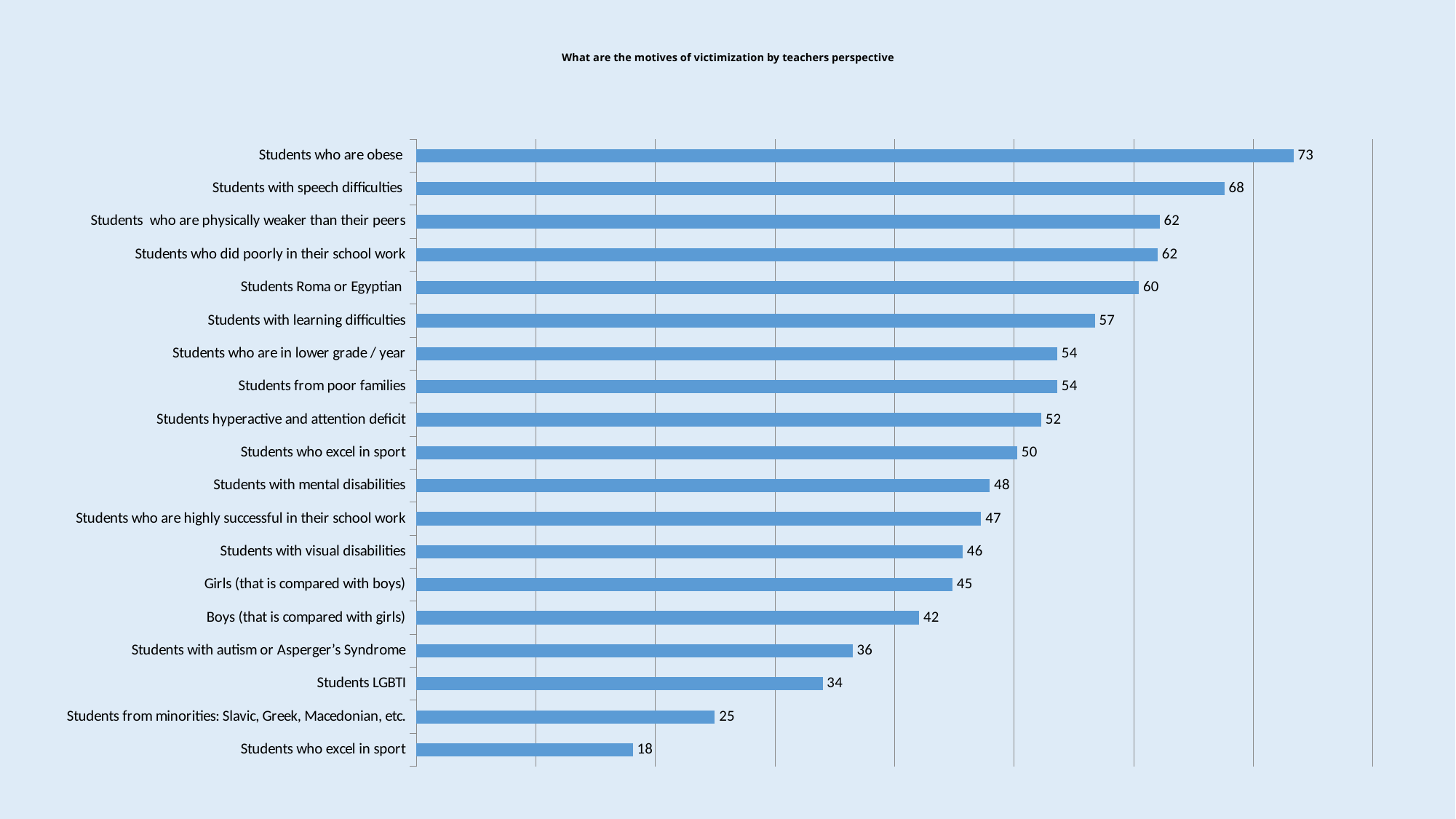
How many categories are shown on the chart? 19 What is the value for Students from minorities: Slavic, Greek, Macedonian, etc.? 25 What is the value for Students with speech difficulties? 68 What is the value for Students Roma or Egyptian? 60 What is the difference between the values for Boys (that is compared with girls) and Students with autism or Asperger's Syndrome? 6 What is the lowest value shown on the chart? 18 What is the value for Students who are obese? 73 What is the value for Students LGBTI? 34 Which is larger, the value for Girls (that is compared with boys) or Boys (that is compared with girls)? Girls (that is compared with boys) What kind of chart is shown on the slide? Bar chart Which category has the highest value? Students who are obese What is the difference between the values for Students who are obese and Students with speech difficulties? 5